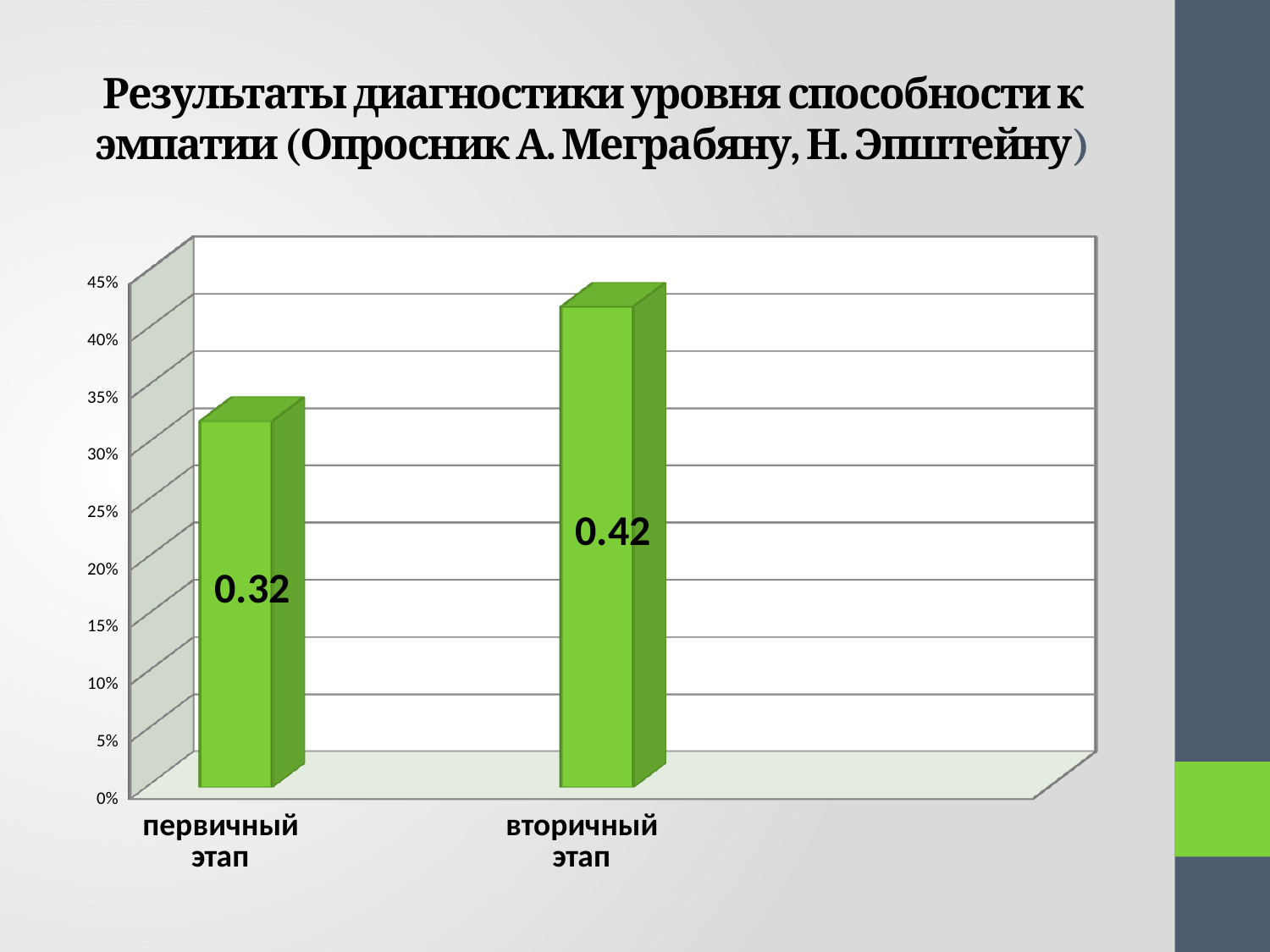
Is the value for первичный этап larger or smaller than the value for вторичный этап? smaller Is the bar for вторичный этап greater or less than 45% on the axis? less Which stage has the lower value? первичный этап Is the bar for первичный этап greater or less than 30% on the axis? greater What kind of chart is shown on the slide? bar chart What colour are the bars in the chart? green How many categories are shown on the x axis? 2 What is the difference between the values for вторичный этап and первичный этап? 0.10 Which stage has the higher value? вторичный этап What value is shown for вторичный этап? 0.42 What value is shown for первичный этап? 0.32 Do the values rise or fall from первичный этап to вторичный этап? rise